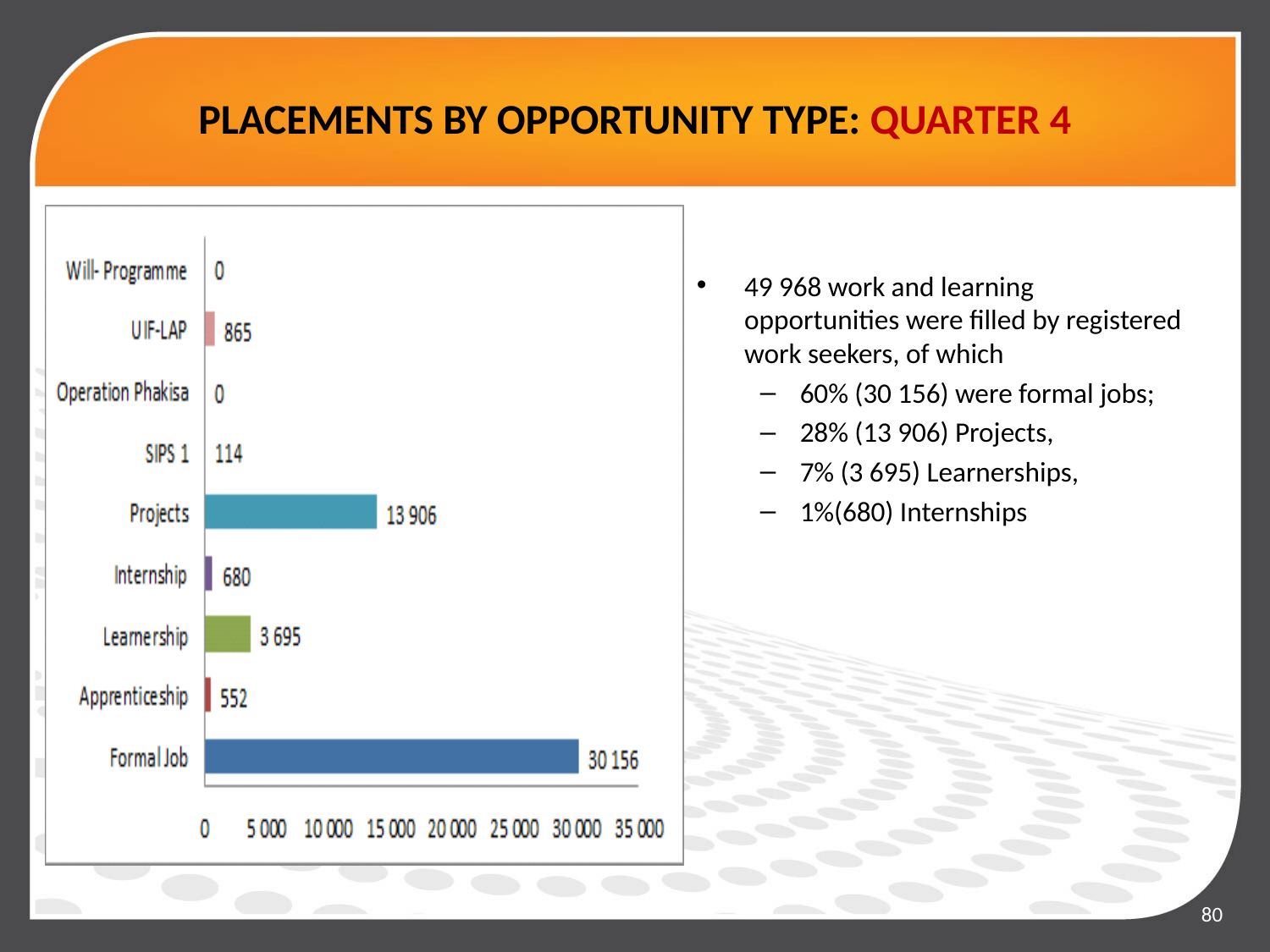
What is the value for Formal Job? 30 156 What is the value for UIF-LAP? 865 Is the value for Projects greater or less than 10 000? greater Which category has the highest value? Formal Job Which is larger, the value for Learnership or the value for UIF-LAP? Learnership What is the difference between the values for Formal Job and Projects? 16 250 What kind of chart is shown on the slide? bar chart How many categories are shown on the chart? 9 What is the difference between the values for Internship and Apprenticeship? 128 What is the value for Projects? 13 906 How many categories have a value of 0? 2 What is the value for Learnership? 3 695